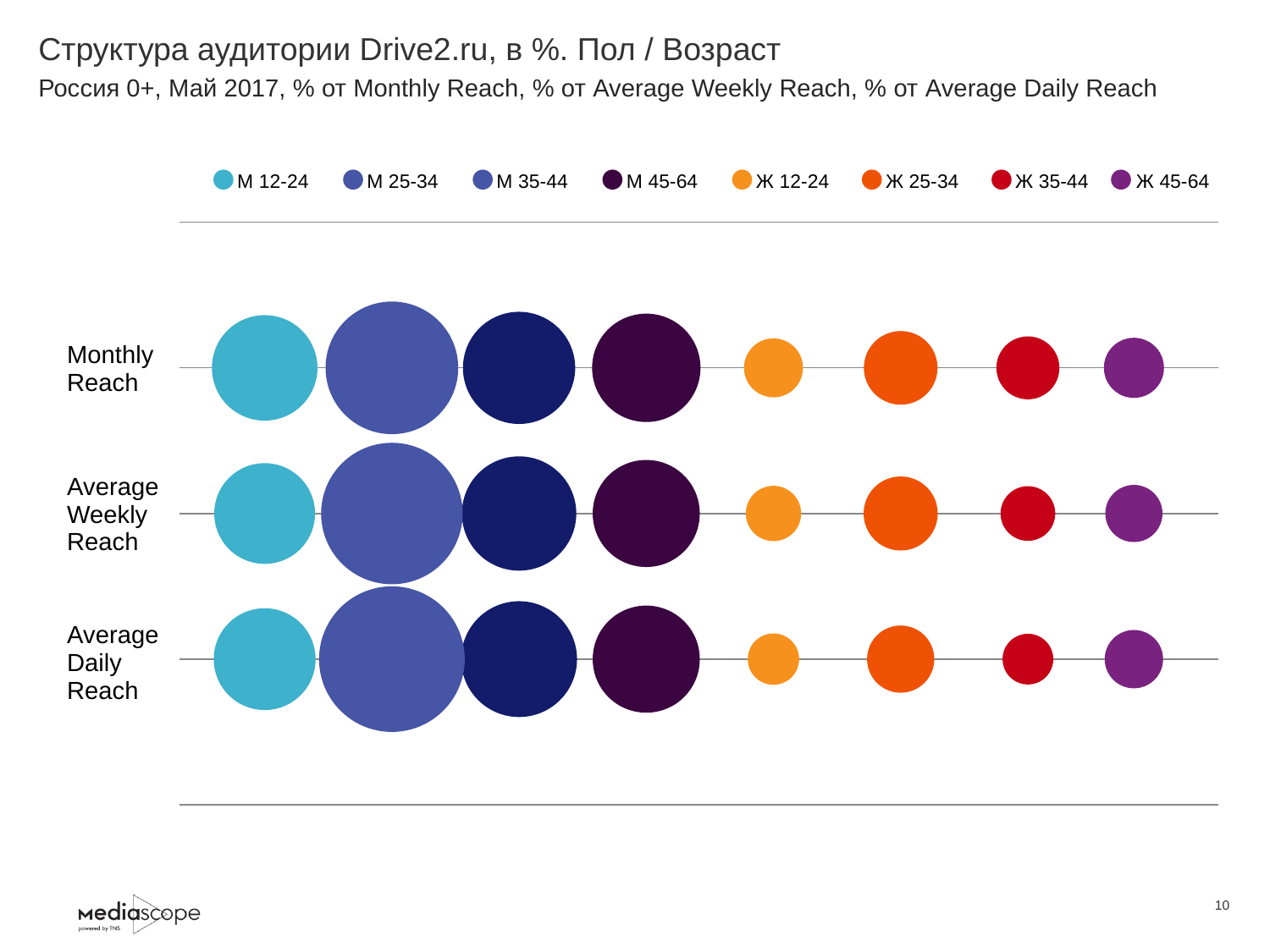
What is the title of the chart on the slide? Структура аудитории Drive2.ru, в %. Пол / Возраст Which gender/age group has the largest bubble in the Monthly Reach row? М 25-34 In the Average Daily Reach row, which bubble is larger: М 45-64 or Ж 25-34? М 45-64 How many series does the legend list? 8 In the Monthly Reach row, which bubble is larger: М 25-34 or Ж 12-24? М 25-34 Which gender/age group has the largest bubble in the Average Weekly Reach row? М 25-34 Which gender/age group has the largest bubble in the Average Daily Reach row? М 25-34 What is the first legend entry of the chart? М 12-24 In the Average Weekly Reach row, which bubble is larger: Ж 25-34 or Ж 35-44? Ж 25-34 What kind of chart is shown on the slide? bubble chart How many reach categories (rows) are plotted on the chart? 3